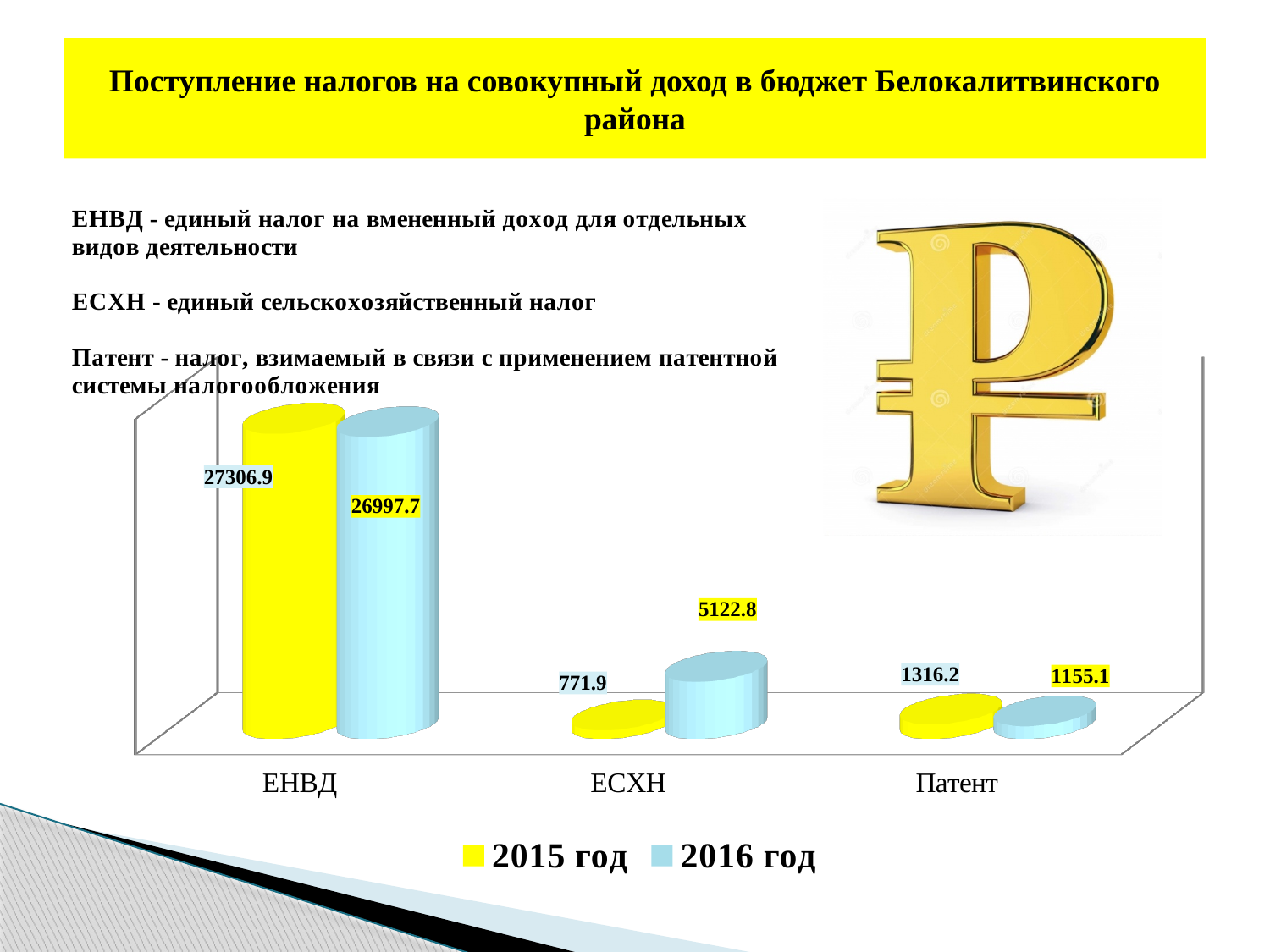
What is the difference between the 2016 год and 2015 год values for ЕСХН? 4350.9 What kind of chart is shown on the slide? Bar chart What is the value for ЕНВД in 2016 год? 26997.7 What is the value for ЕНВД in 2015 год? 27306.9 How many categories are shown on the x axis? 3 Which is larger for ЕНВД: the 2015 год value or the 2016 год value? 2015 год What is the difference between the 2015 год and 2016 год values for Патент? 161.1 How many series does the legend list? 2 What is the value for Патент in 2015 год? 1316.2 Which category has the highest value in 2016 год? ЕНВД Which category has the lowest value in 2015 год? ЕСХН What is the value for ЕСХН in 2016 год? 5122.8